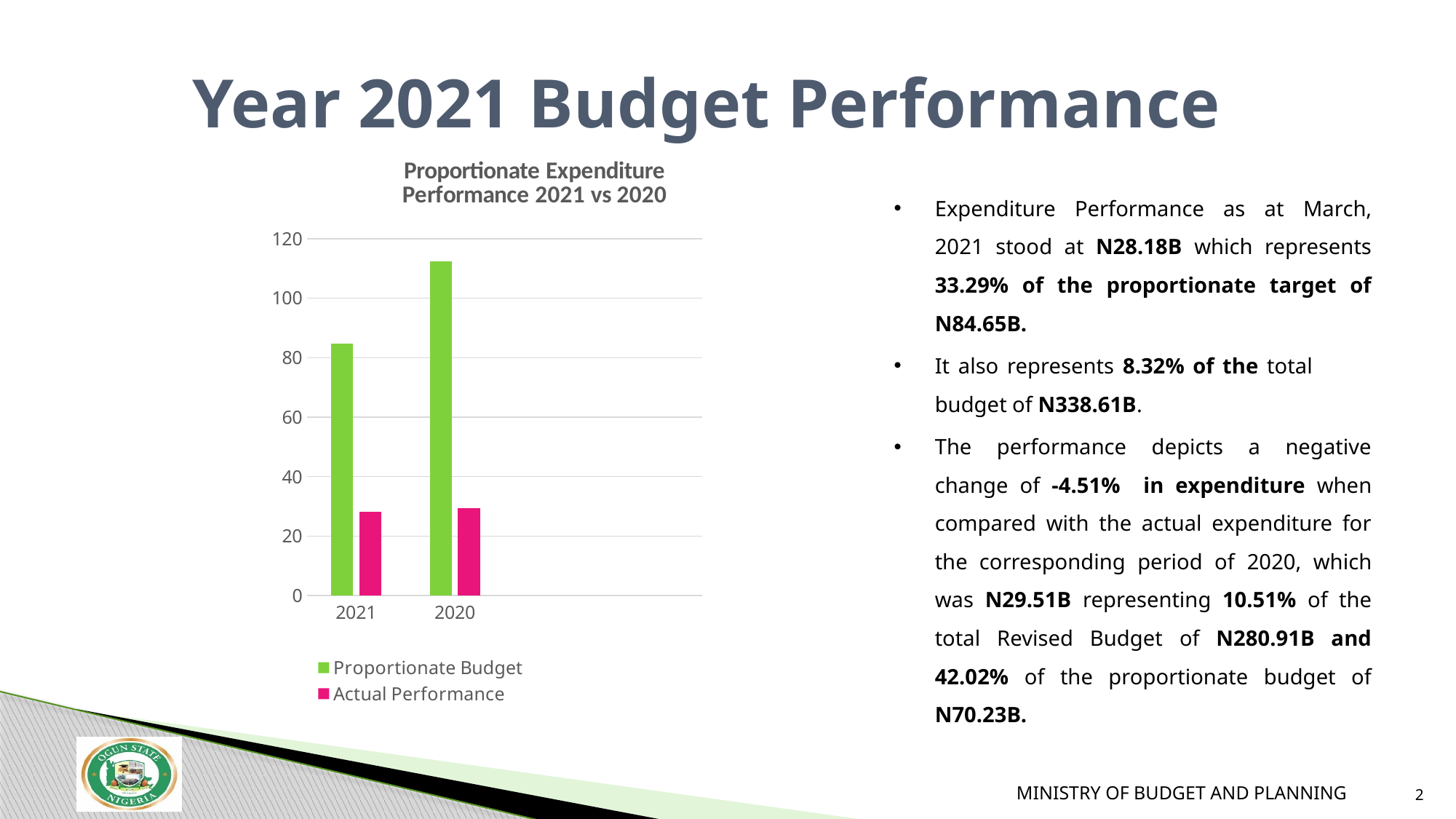
Is the Actual Performance value for 2021 greater or less than 40? less Is the Actual Performance value for 2020 greater or less than 20? greater Is the Proportionate Budget value for 2020 greater or less than 100? greater What is the title of the chart? Proportionate Expenditure Performance 2021 vs 2020 Which year has the higher Proportionate Budget bar? 2020 How many categories are shown on the x axis of the chart? 2 For 2021, which is larger: the Proportionate Budget or the Actual Performance? Proportionate Budget How many series does the chart's legend list? 2 What kind of chart is shown on the slide? bar chart What colour are the Actual Performance bars in the chart? pink